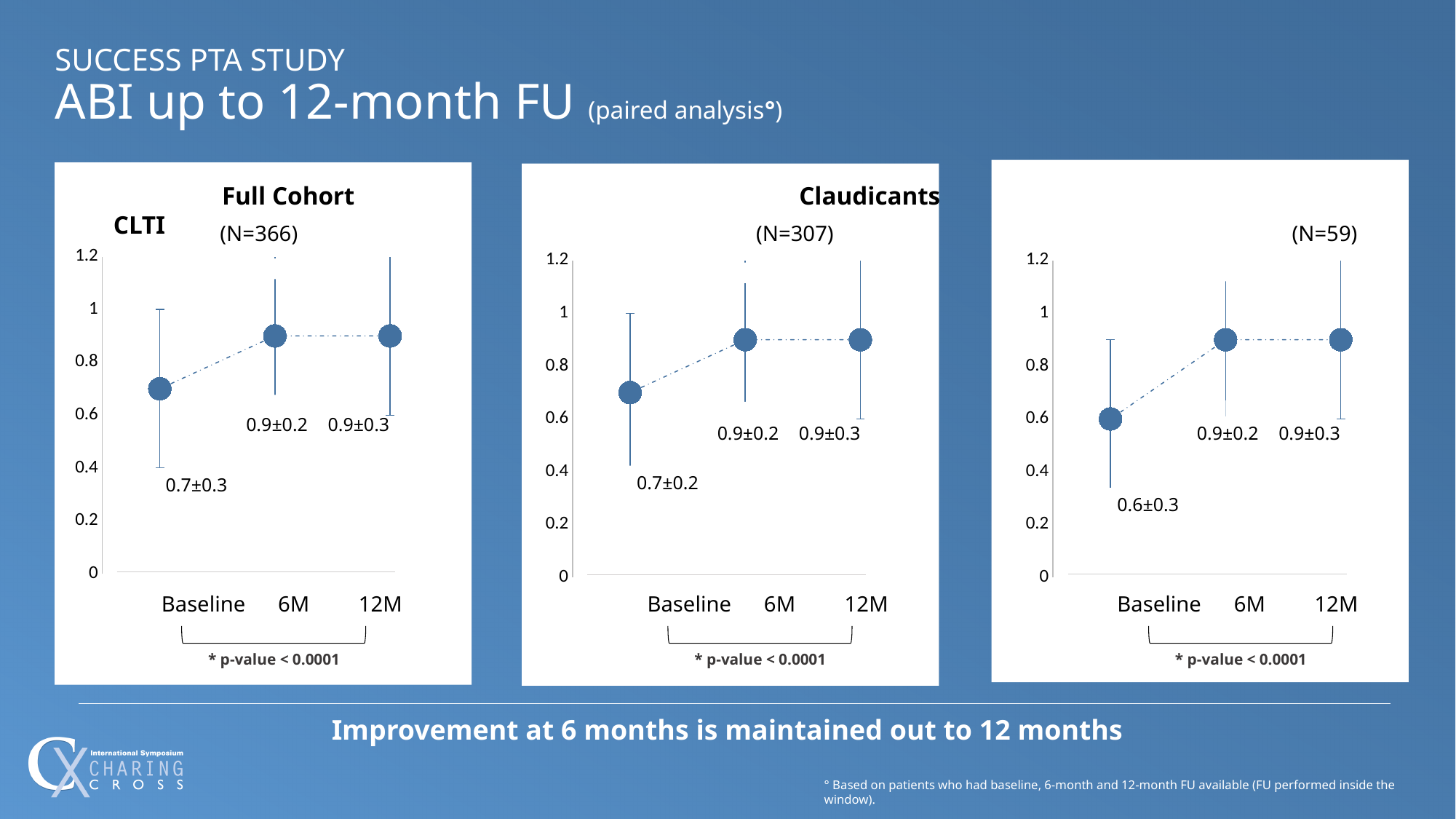
On the right chart (N=59), what is the difference between the mean ABI at 6M and at Baseline? 0.3 On the left chart (N=366), is the mean ABI at 6M greater or less than 0.8? greater How many time points are plotted on each chart? 3 On the middle chart (N=307), is the mean ABI at Baseline greater or less than 0.8? less On the middle chart (N=307), what is the ABI value labelled at Baseline? 0.7±0.2 On the right chart (N=59), what is the ABI value labelled at 6M? 0.9±0.2 On the right chart (N=59), what is the ABI value labelled at Baseline? 0.6±0.3 On the left chart (N=366), what is the ABI value labelled at Baseline? 0.7±0.3 On the left chart (N=366), how does the mean ABI change from Baseline to 6M to 12M? Rises from Baseline to 6M, then stays flat to 12M On the right chart (N=59), which time point has the lowest mean ABI? Baseline What p-value is stated below each chart for the change from Baseline? p-value < 0.0001 On the left chart (N=366), what is the ABI value labelled at 12M? 0.9±0.3